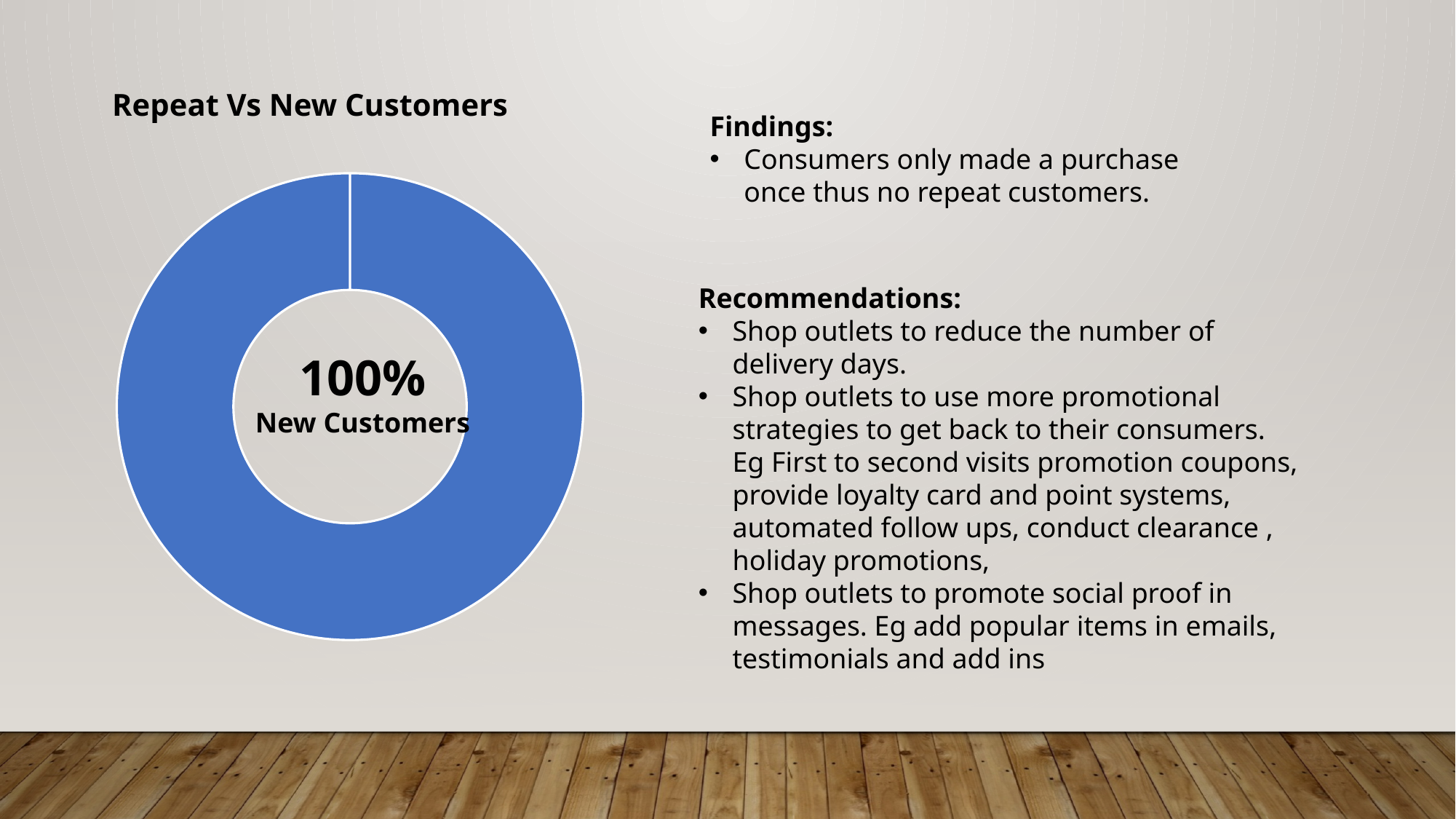
Which category is labelled in the centre of the chart? New Customers Which category accounts for the largest share of the chart? New Customers What share of the chart do New Customers make up? 100% Is the share for New Customers greater or less than 50%? greater What value is printed in the centre of the doughnut chart? 100% What kind of chart is shown on the slide? doughnut chart How many slices are visible in the doughnut chart? 1 What colour is the slice in the doughnut chart? blue What is the title of the chart? Repeat Vs New Customers